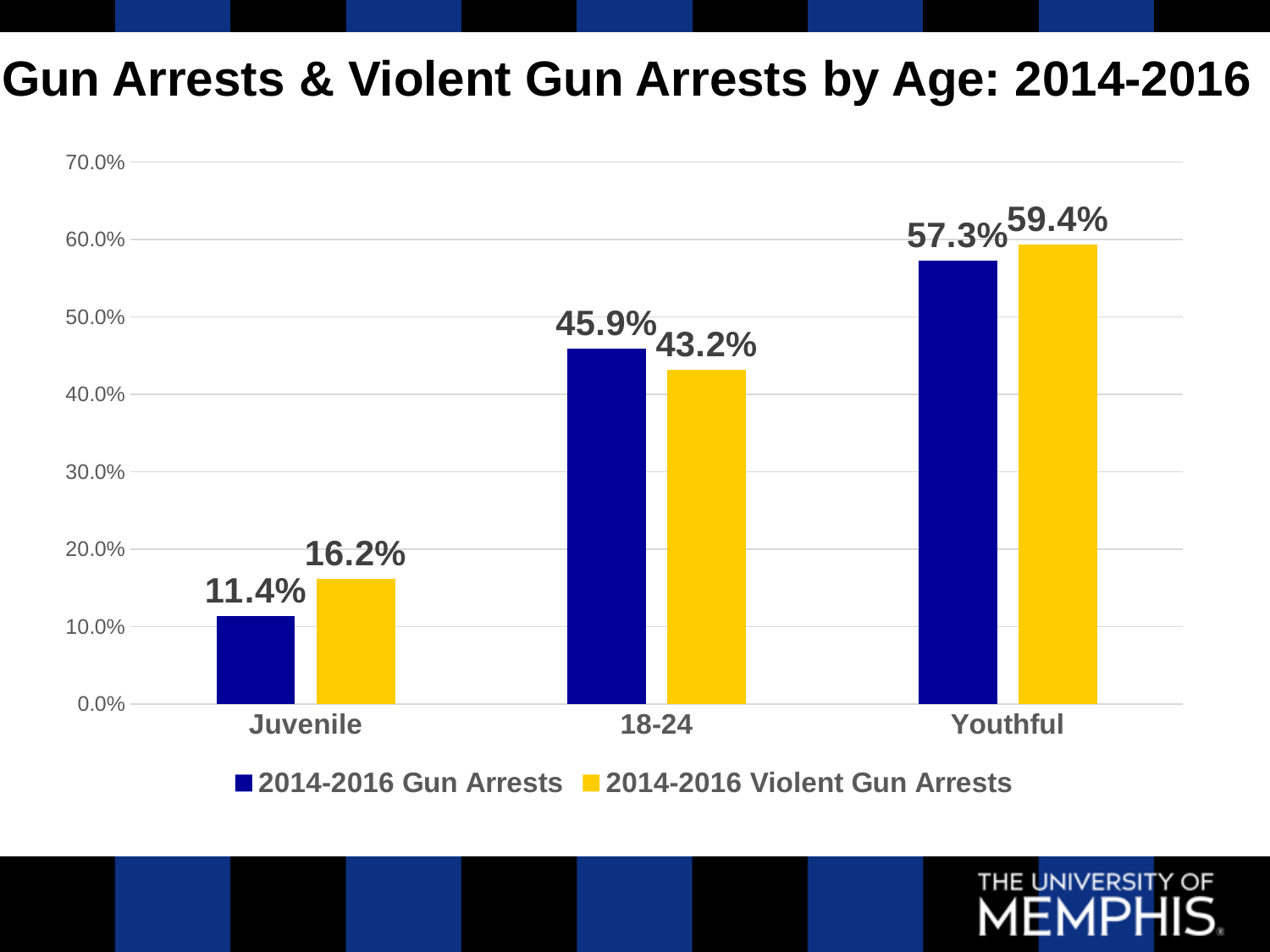
How many age categories are shown on the x axis? 3 What is the 2014-2016 Gun Arrests value for Youthful? 57.3% What is the 2014-2016 Violent Gun Arrests value for 18-24? 43.2% What kind of chart is shown on the slide? Bar chart How many series does the legend list? 2 Do the 2014-2016 Gun Arrests values rise or fall from Juvenile to Youthful? Rise Which age category has the highest 2014-2016 Violent Gun Arrests value? Youthful For 18-24, which is larger: 2014-2016 Gun Arrests or 2014-2016 Violent Gun Arrests? 2014-2016 Gun Arrests Is the 2014-2016 Violent Gun Arrests value for Youthful greater or less than 50.0%? greater What is the 2014-2016 Gun Arrests value for Juvenile? 11.4% What is the difference between the 2014-2016 Violent Gun Arrests and 2014-2016 Gun Arrests values for Juvenile? 4.8% Which age category has the lowest 2014-2016 Gun Arrests value? Juvenile